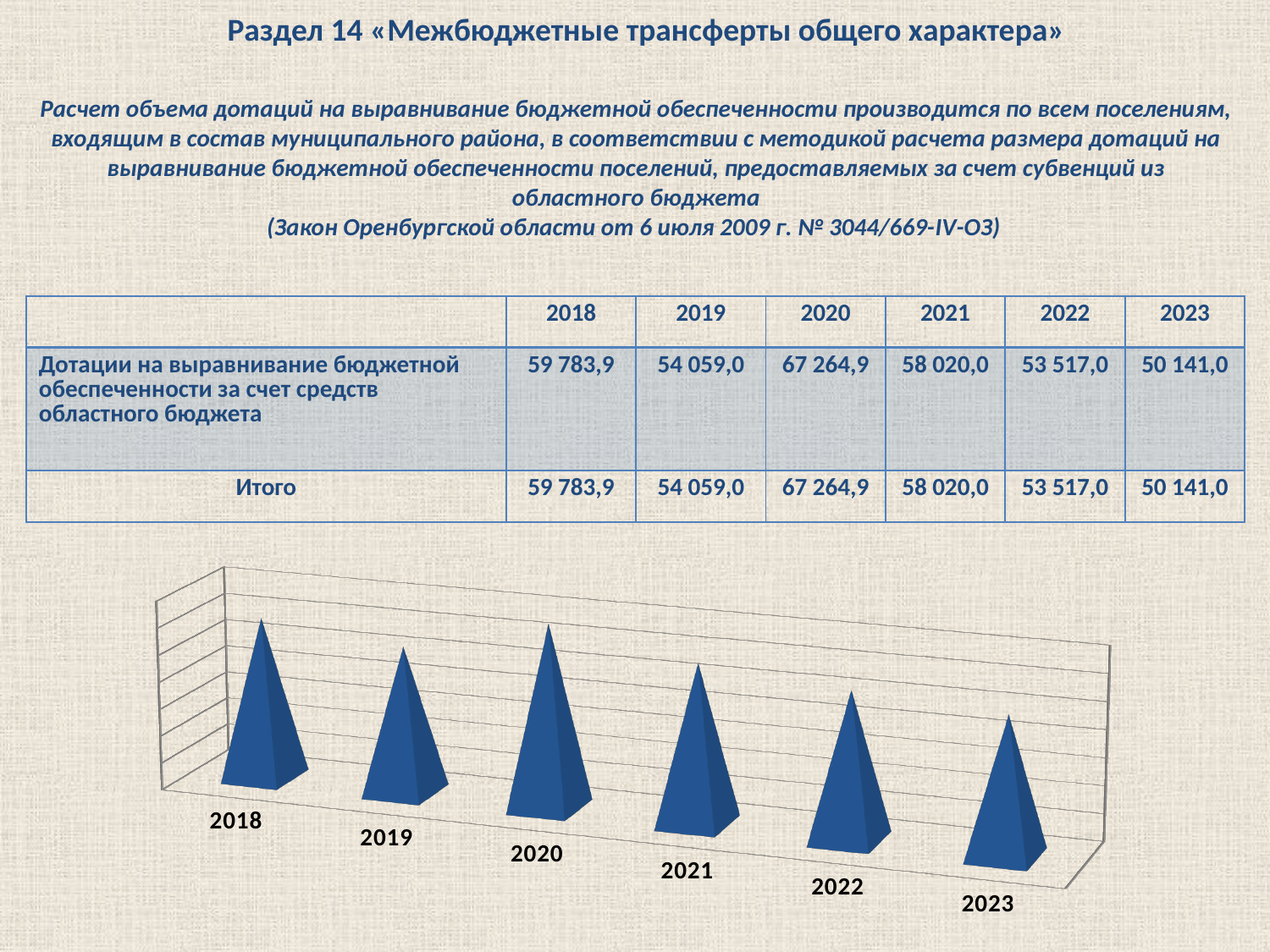
What kind of chart is shown at the bottom of the slide? bar chart Which bar is taller in the chart, 2021 or 2022? 2021 How many years (categories) are plotted in the chart? 6 According to the slide, what is the value of the subsidies (дотации) for 2020? 67 264,9 What is the difference between the 2020 value and the 2023 value shown on the slide? 17 123,9 What is the difference between the 2018 value and the 2019 value shown on the slide? 5 724,9 From 2020 to 2023, do the bar values rise or fall? fall Which year has the shortest bar in the chart? 2023 Which year has the tallest bar in the chart? 2020 According to the slide, what is the value of the subsidies (дотации) for 2018? 59 783,9 According to the slide, what is the value of the subsidies (дотации) for 2023? 50 141,0 Which bar is taller in the chart, 2018 or 2019? 2018